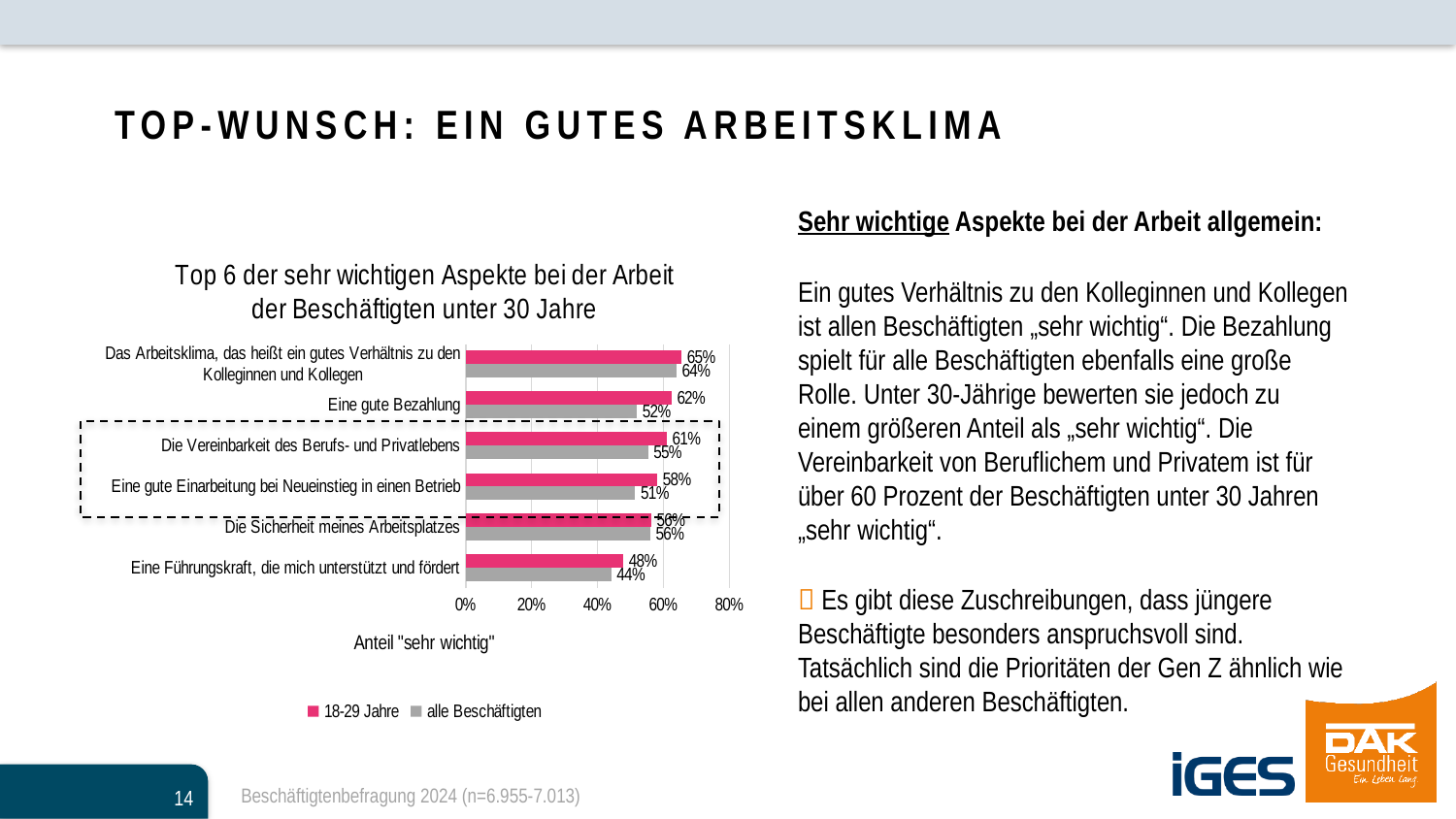
What is the value for "alle Beschäftigten" for "Eine gute Bezahlung"? 52% What is the value for "18-29 Jahre" for "Die Vereinbarkeit des Berufs- und Privatlebens"? 61% Which category has the lowest value for "alle Beschäftigten"? Eine Führungskraft, die mich unterstützt und fördert How many series does the chart legend list? 2 For "Eine gute Einarbeitung bei Neueinstieg in einen Betrieb", which series has the larger value, "18-29 Jahre" or "alle Beschäftigten"? 18-29 Jahre What kind of chart is shown on the slide? bar chart Which category has the highest value for "18-29 Jahre"? Das Arbeitsklima, das heißt ein gutes Verhältnis zu den Kolleginnen und Kollegen What is the value for "18-29 Jahre" for "Das Arbeitsklima, das heißt ein gutes Verhältnis zu den Kolleginnen und Kollegen"? 65% What is the value for "alle Beschäftigten" for "Eine Führungskraft, die mich unterstützt und fördert"? 44% What is the difference between the "18-29 Jahre" and "alle Beschäftigten" values for "Eine gute Bezahlung"? 10% How many categories (aspects) are shown in the chart? 6 What is the title of the chart? Top 6 der sehr wichtigen Aspekte bei der Arbeit der Beschäftigten unter 30 Jahre